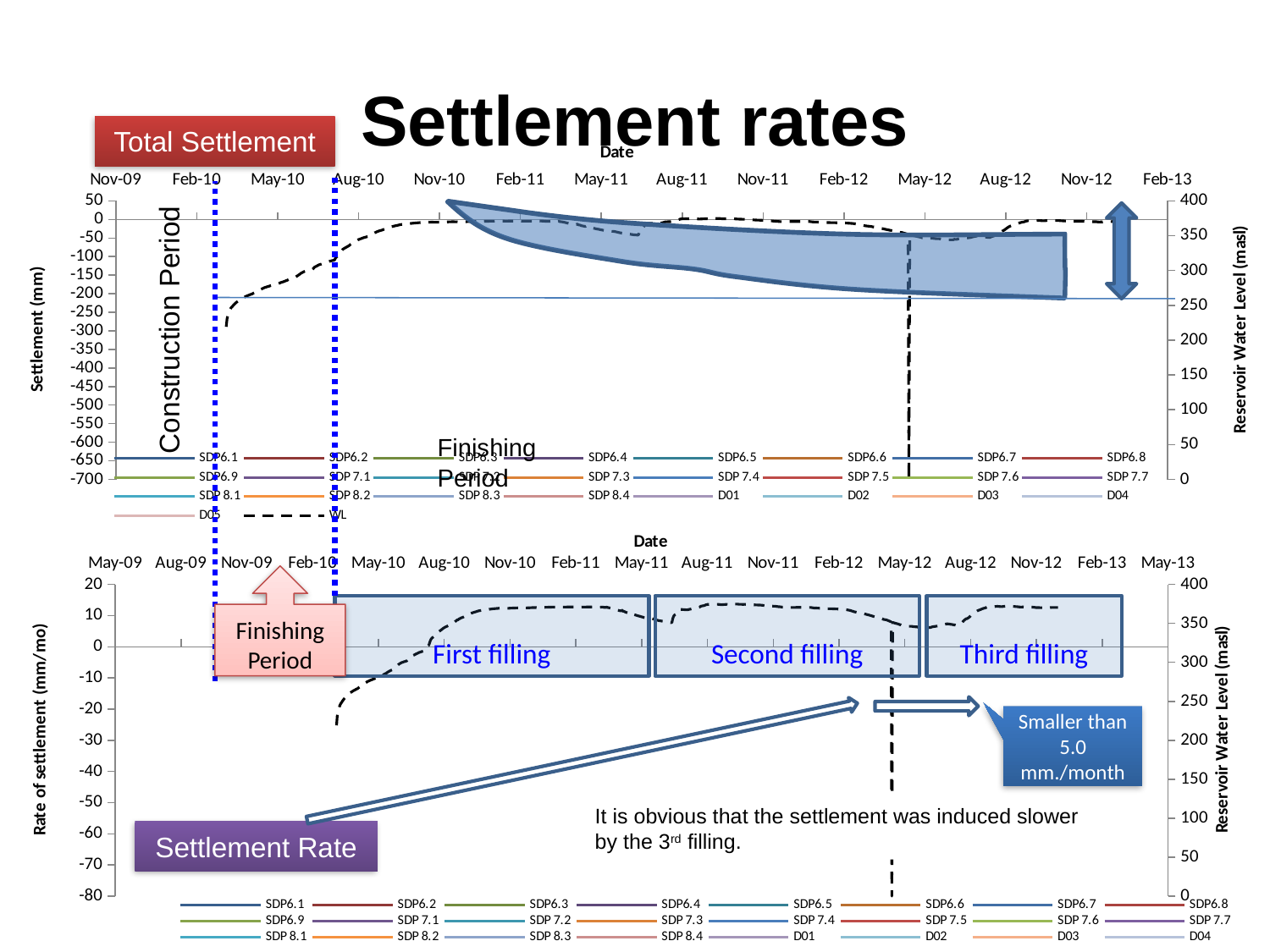
How many date labels are shown on the x axis of the Settlement Rate chart? 17 In the Settlement Rate chart, does the dashed line rise or fall between Feb-10 and Nov-10? rise What kind of chart is the Total Settlement chart at the top of the slide? line chart What is the title of the left vertical axis of the Settlement Rate chart? Rate of settlement (mm/mo) How many series does the legend of the Settlement Rate chart list? 24 How many series does the legend of the Total Settlement chart list? 26 How many date labels are shown on the x axis of the Total Settlement chart? 14 In the Total Settlement chart, which legend series is drawn as a dashed line? WL What kind of chart is the Settlement Rate chart at the bottom of the slide? line chart In the Settlement Rate chart, does the dashed line rise or fall between Feb-12 and May-12? fall In the Total Settlement chart, does the dashed WL line rise or fall between Feb-10 and Nov-10? rise